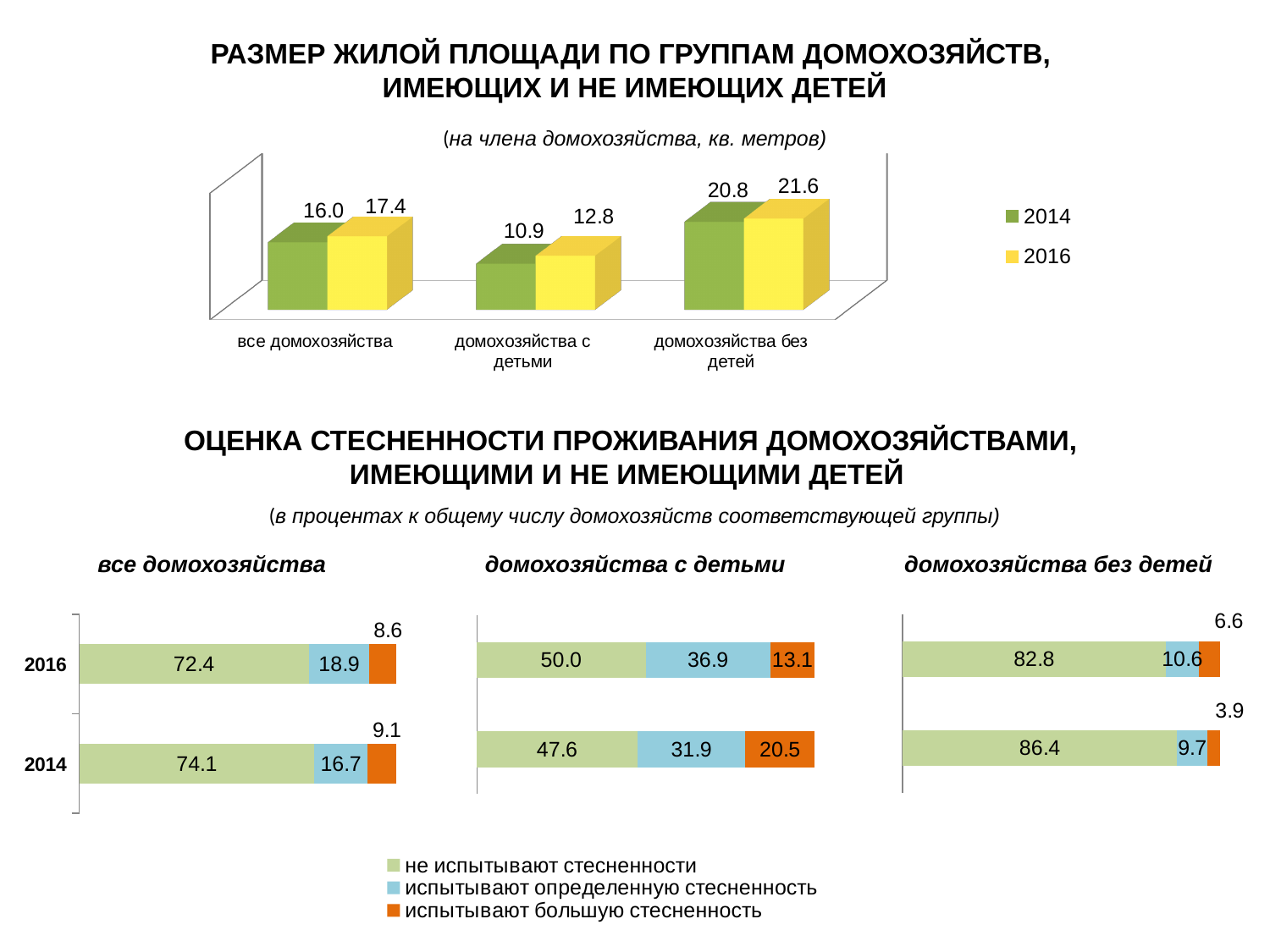
In the bottom-middle chart 'домохозяйства с детьми', what is the difference between the 2014 and 2016 values for 'испытывают большую стесненность'? 7.4 In the top chart 'Размер жилой площади по группам домохозяйств', which category has the highest value in 2016? домохозяйства без детей In the top chart 'Размер жилой площади по группам домохозяйств', how many series does the legend list? 2 In the bottom-left chart 'все домохозяйства', what is the share of households that 'не испытывают стесненности' in 2014? 74.1 In the top chart 'Размер жилой площади по группам домохозяйств', what kind of chart is it? bar chart In the top chart 'Размер жилой площади по группам домохозяйств', what is the value for 'домохозяйства с детьми' in 2016? 12.8 In the bottom charts, how many series does the shared legend list? 3 In the top chart 'Размер жилой площади по группам домохозяйств', which category has the lowest value in 2014? домохозяйства с детьми In the bottom-right chart 'домохозяйства без детей', which year has the larger value for 'испытывают определенную стесненность', 2014 or 2016? 2016 In the bottom-middle chart 'домохозяйства с детьми', what is the value for 'испытывают большую стесненность' in 2016? 13.1 In the top chart 'Размер жилой площади по группам домохозяйств', what is the difference between the 2016 and 2014 values for 'все домохозяйства'? 1.4 In the top chart 'Размер жилой площади по группам домохозяйств', what is the value for 'домохозяйства без детей' in 2014? 20.8